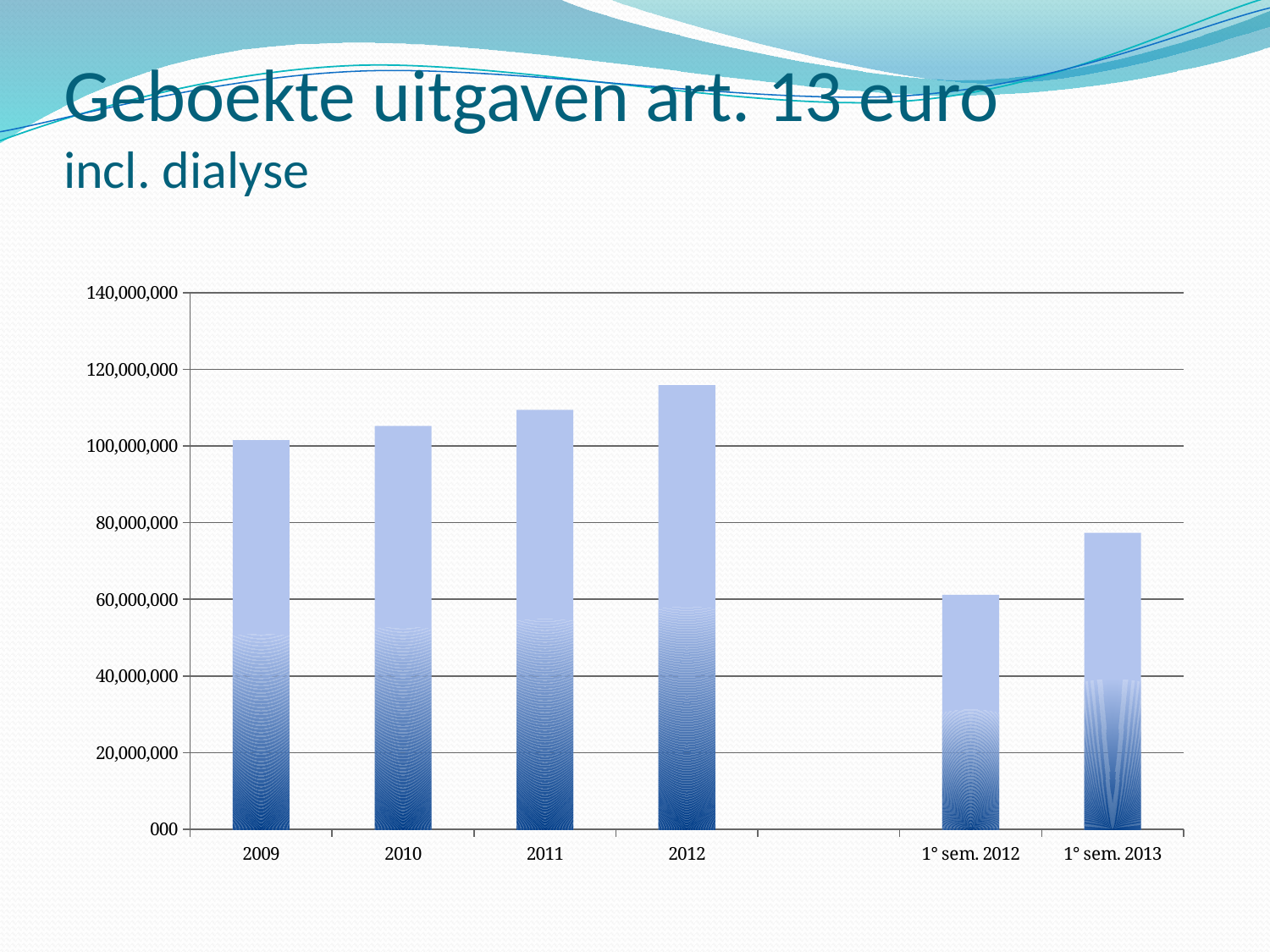
Do the values rise or fall from 2009 to 2012? rise Is the value for 2012 greater or less than 100,000,000? greater Is the value for 2010 greater or less than 100,000,000? greater What is the title of the slide containing the chart? Geboekte uitgaven art. 13 euro incl. dialyse Is the value for 2011 greater or less than 120,000,000? less Which is larger, the value for 2009 or the value for 2012? 2012 How many bars are plotted in the chart? 6 Which category has the highest value in the chart? 2012 What kind of chart is shown on the slide? bar chart Which category has the lowest value in the chart? 1° sem. 2012 Which is larger, the value for 1° sem. 2012 or the value for 1° sem. 2013? 1° sem. 2013